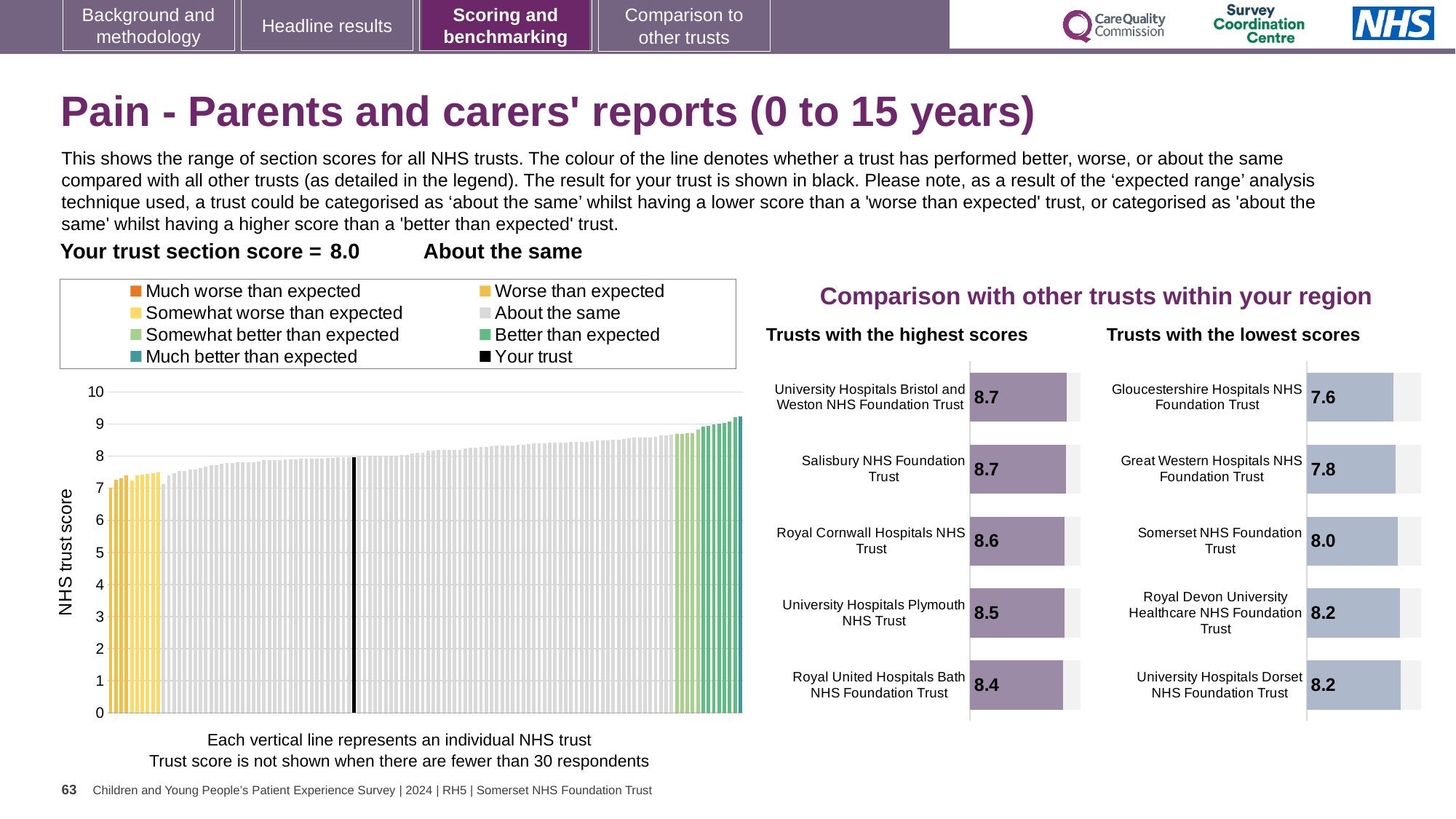
In the 'Trusts with the lowest scores' chart, what is the score for Gloucestershire Hospitals NHS Foundation Trust? 7.6 In the main NHS trust score chart, do the trust scores rise or fall from left to right? rise In the 'Trusts with the highest scores' chart, which has the higher score: University Hospitals Plymouth NHS Trust or Royal United Hospitals Bath NHS Foundation Trust? University Hospitals Plymouth NHS Trust In the 'Trusts with the highest scores' chart, what is the score for Royal Cornwall Hospitals NHS Trust? 8.6 How many entries does the legend above the main NHS trust score chart list? 8 How many trusts are listed in the 'Trusts with the lowest scores' chart? 5 In the 'Trusts with the lowest scores' chart, which trust has the lowest score? Gloucestershire Hospitals NHS Foundation Trust In the main NHS trust score chart, is the value for the black 'Your trust' bar greater or less than 9? less In the 'Trusts with the highest scores' chart, which trust has the lowest score shown? Royal United Hospitals Bath NHS Foundation Trust In the main NHS trust score chart, what is the section score for your trust? 8.0 In the 'Trusts with the lowest scores' chart, what is the difference between the scores of Somerset NHS Foundation Trust and Gloucestershire Hospitals NHS Foundation Trust? 0.4 What kind of chart is the main NHS trust score chart on the left? bar chart